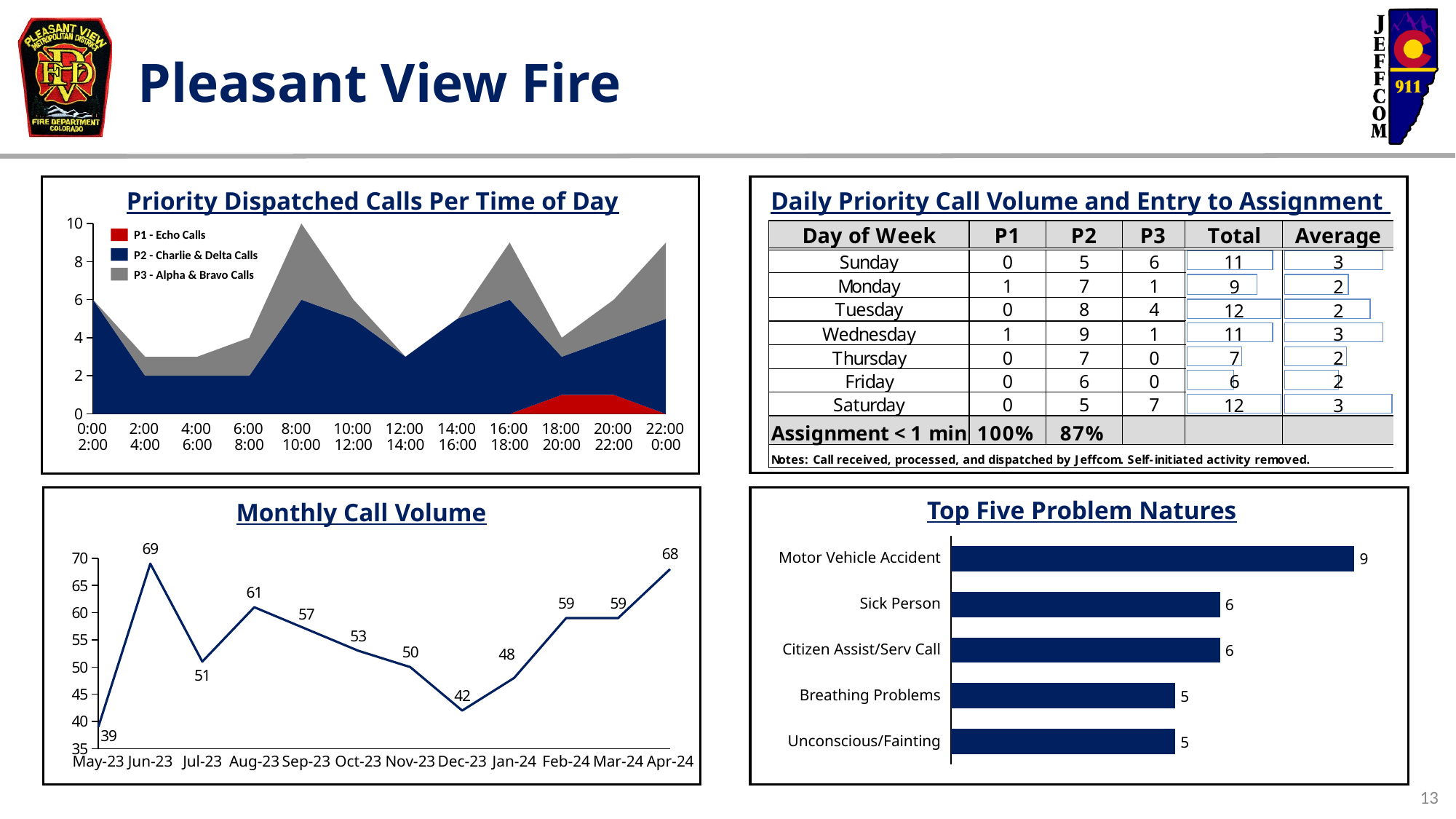
In the Monthly Call Volume chart, which month had the lowest call volume? May-23 In the Monthly Call Volume chart, what was the call volume in Jun-23? 69 In the Monthly Call Volume chart, what was the call volume in Dec-23? 42 In the Top Five Problem Natures chart, is the value for Sick Person larger than the value for Breathing Problems? Yes In the Monthly Call Volume chart, which month had the highest call volume? Jun-23 In the Top Five Problem Natures chart, which problem nature has the highest count? Motor Vehicle Accident What kind of chart is the Top Five Problem Natures chart? Bar chart In the Monthly Call Volume chart, what is the difference between the Apr-24 and Jan-24 call volumes? 20 In the Priority Dispatched Calls Per Time of Day chart, is the total number of calls for the 8:00-10:00 period greater or less than 8? greater In the Monthly Call Volume chart, how many months are plotted? 12 In the Top Five Problem Natures chart, how many calls were for Motor Vehicle Accident? 9 In the Priority Dispatched Calls Per Time of Day chart, how many series does the legend list? 3